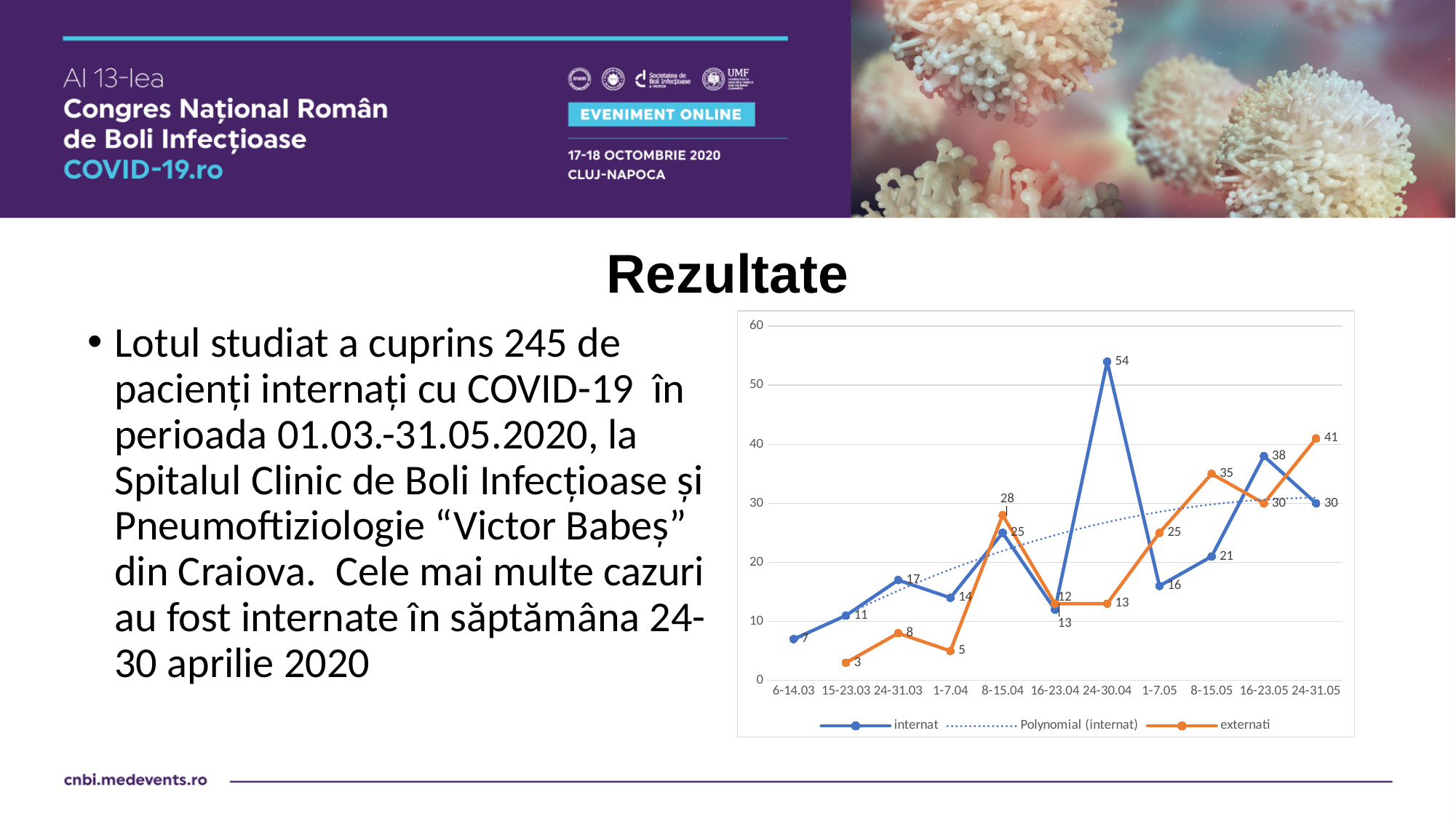
What is the value of the externati series for 24-31.05? 41 What is the value of the externati series for 8-15.04? 28 What is the difference between the internat values for 24-30.04 and 1-7.05? 38 In which week does the externati series have its lowest value? 15-23.03 How many entries does the legend list? 3 What type of chart is shown on the slide? line chart What is the value of the internat series for 24-30.04? 54 Which series has the larger value for 16-23.05, internat or externati? internat What is the value of the internat series for 6-14.03? 7 How many weekly categories are shown on the x axis? 11 In which week does the internat series reach its highest value? 24-30.04 What is the difference between the internat and externati values for 8-15.05? 14